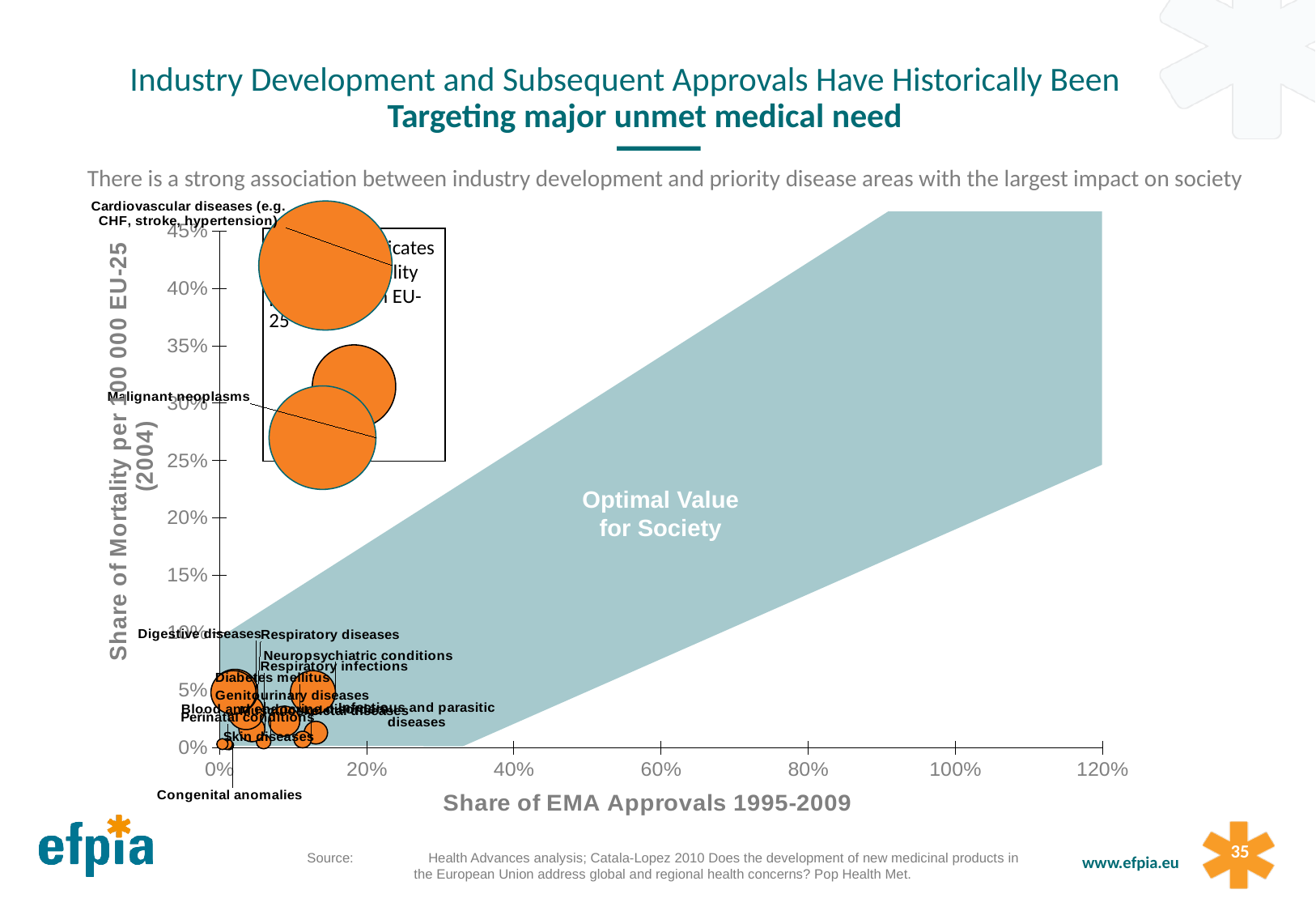
Which has a larger share of mortality, Cardiovascular diseases or Malignant neoplasms? Cardiovascular diseases Is the share of EMA approvals for Cardiovascular diseases greater or less than 20%? less What kind of chart is shown on the slide? bubble chart Which disease area has the highest share of mortality on the chart? Cardiovascular diseases (e.g. CHF, stroke, hypertension) Is the share of mortality for Malignant neoplasms greater or less than 35%? less Is the share of mortality for Malignant neoplasms greater or less than 20%? greater What label is written inside the shaded band on the chart? Optimal Value for Society What is the title of the x axis of the chart? Share of EMA Approvals 1995-2009